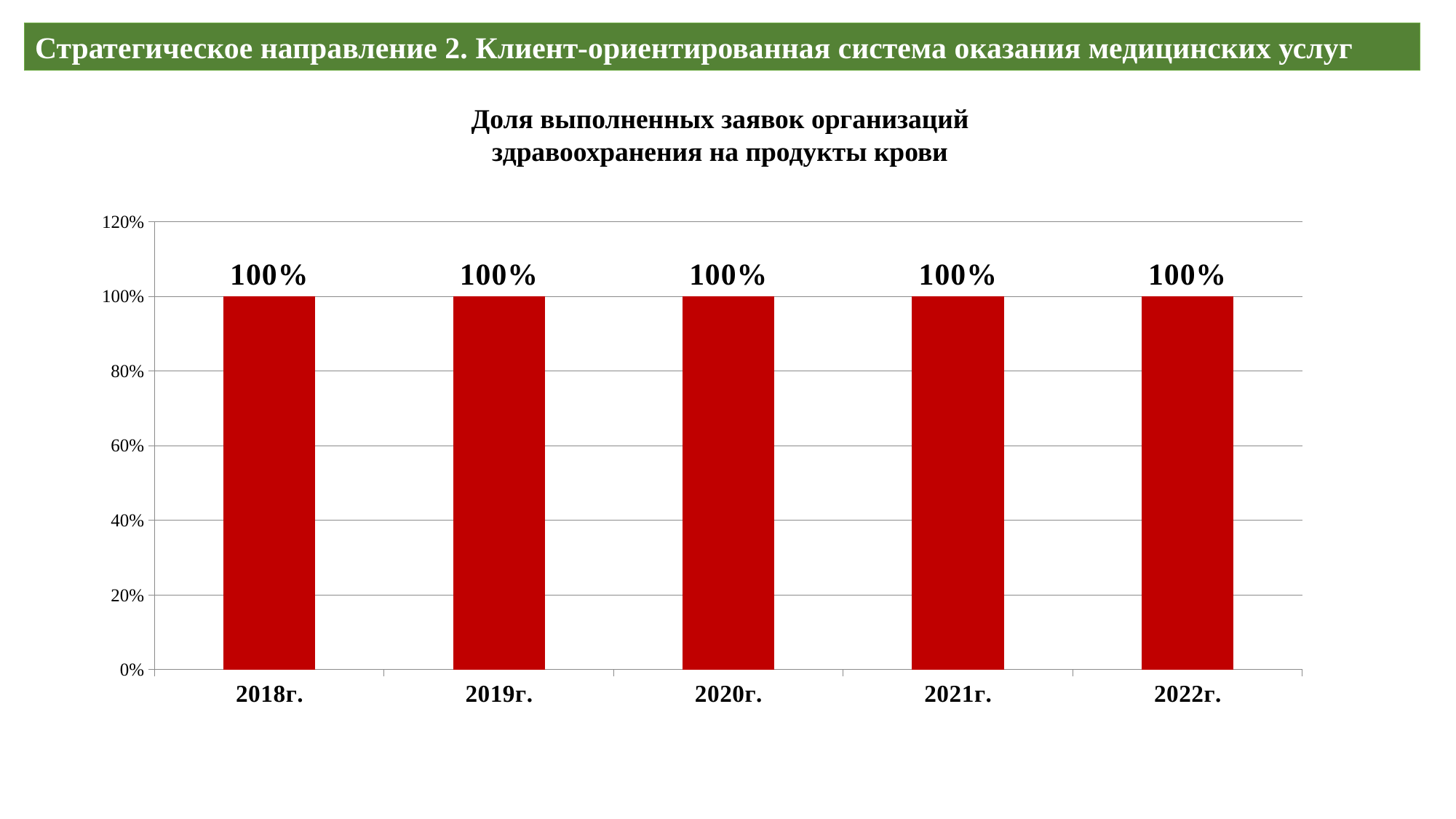
What colour are the bars? red Do the values rise, fall or stay the same from 2018г. to 2022г.? stay the same Is the value for 2019г. greater or less than 120%? less What kind of chart is this? bar chart What is the value for 2022г.? 100% What is the value for 2018г.? 100% How many years are shown on the x axis? 5 Is the value for 2021г. greater or less than 80%? greater What is the difference between the values for 2019г. and 2021г.? 0% What is the value for 2020г.? 100% What is the title of the chart? Доля выполненных заявок организаций здравоохранения на продукты крови What is the highest value shown on the y axis? 120%